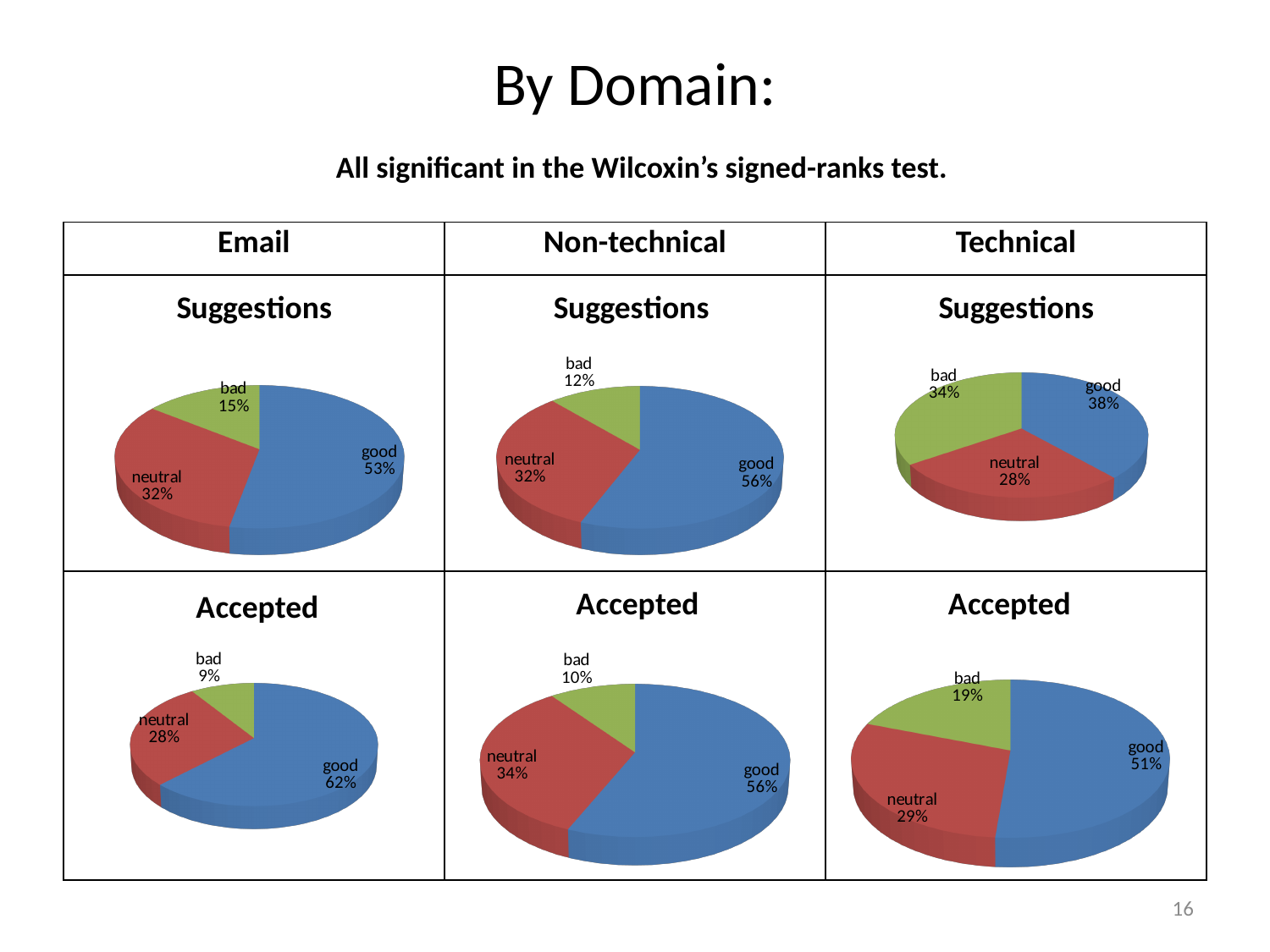
In the Email Accepted pie chart, what is the difference between the good and neutral shares? 34% In the Email Accepted pie chart, what share is labelled bad? 9% In the Technical Suggestions pie chart, what is the difference between the good and neutral shares? 10% In the Non-technical Accepted pie chart, which slice is the largest? good In the Email Suggestions pie chart, which slice is the smallest? bad In the Non-technical Suggestions pie chart, what share is labelled neutral? 32% How many slices does the Email Suggestions pie chart have? 3 In the Technical Suggestions pie chart, what share is labelled bad? 34% Which is larger: the bad share in the Technical Accepted pie chart or the bad share in the Non-technical Accepted pie chart? Technical Accepted What kind of chart is used in the Technical Accepted cell? pie chart